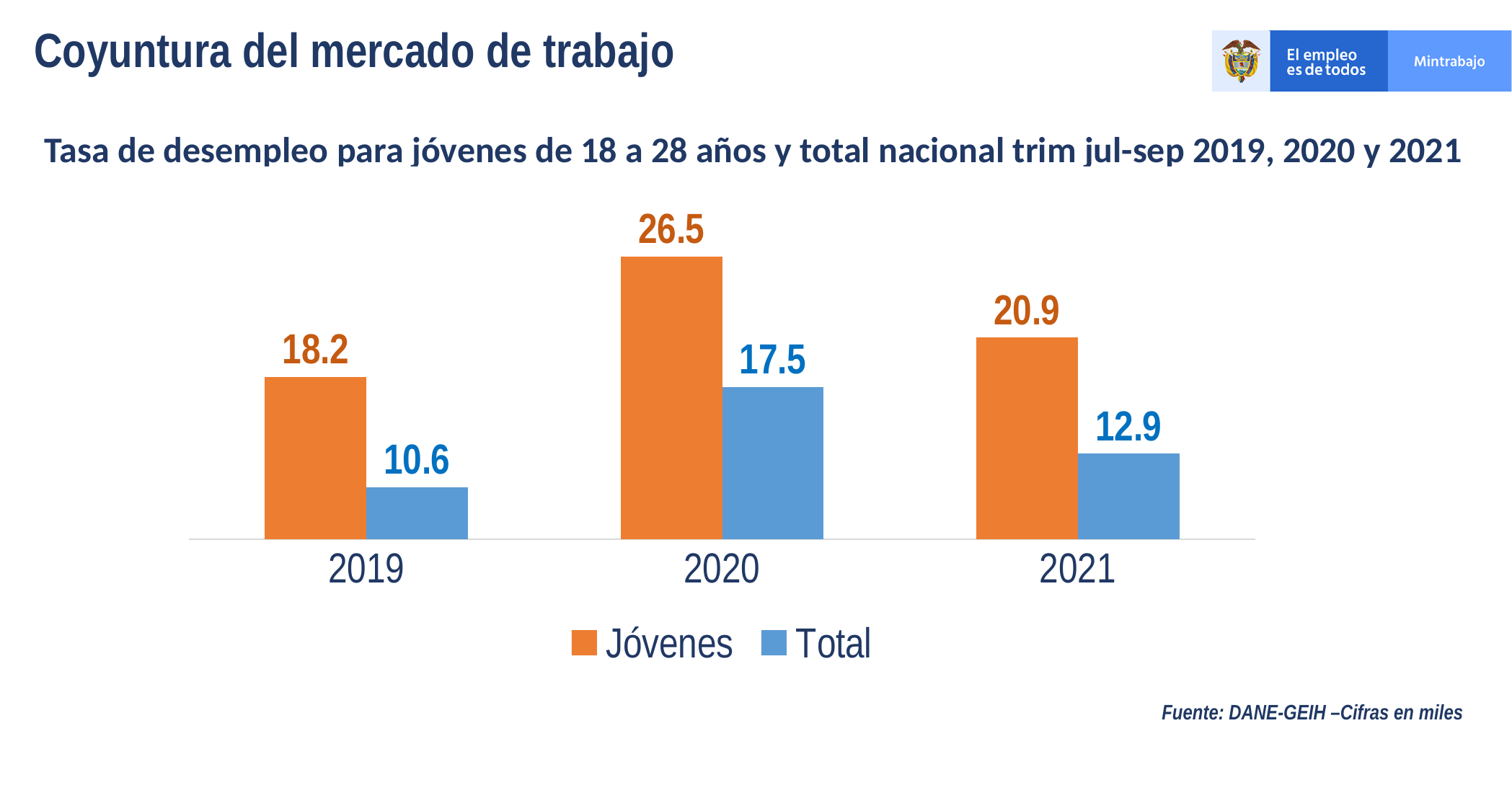
What kind of chart is shown on the slide? Bar chart What is the difference between the Jóvenes and Total values in 2020? 9.0 What is the value for Jóvenes in 2020? 26.5 In which year is the Total value lowest? 2019 What is the difference between the Jóvenes values for 2020 and 2021? 5.6 How many years are shown on the x axis? 3 How many series does the legend list? 2 What is the value for Total in 2019? 10.6 In which year is the Jóvenes value highest? 2020 Which is larger, the Jóvenes value in 2019 or the Total value in 2020? Jóvenes value in 2019 What is the value for Jóvenes in 2021? 20.9 What is the value for Total in 2021? 12.9